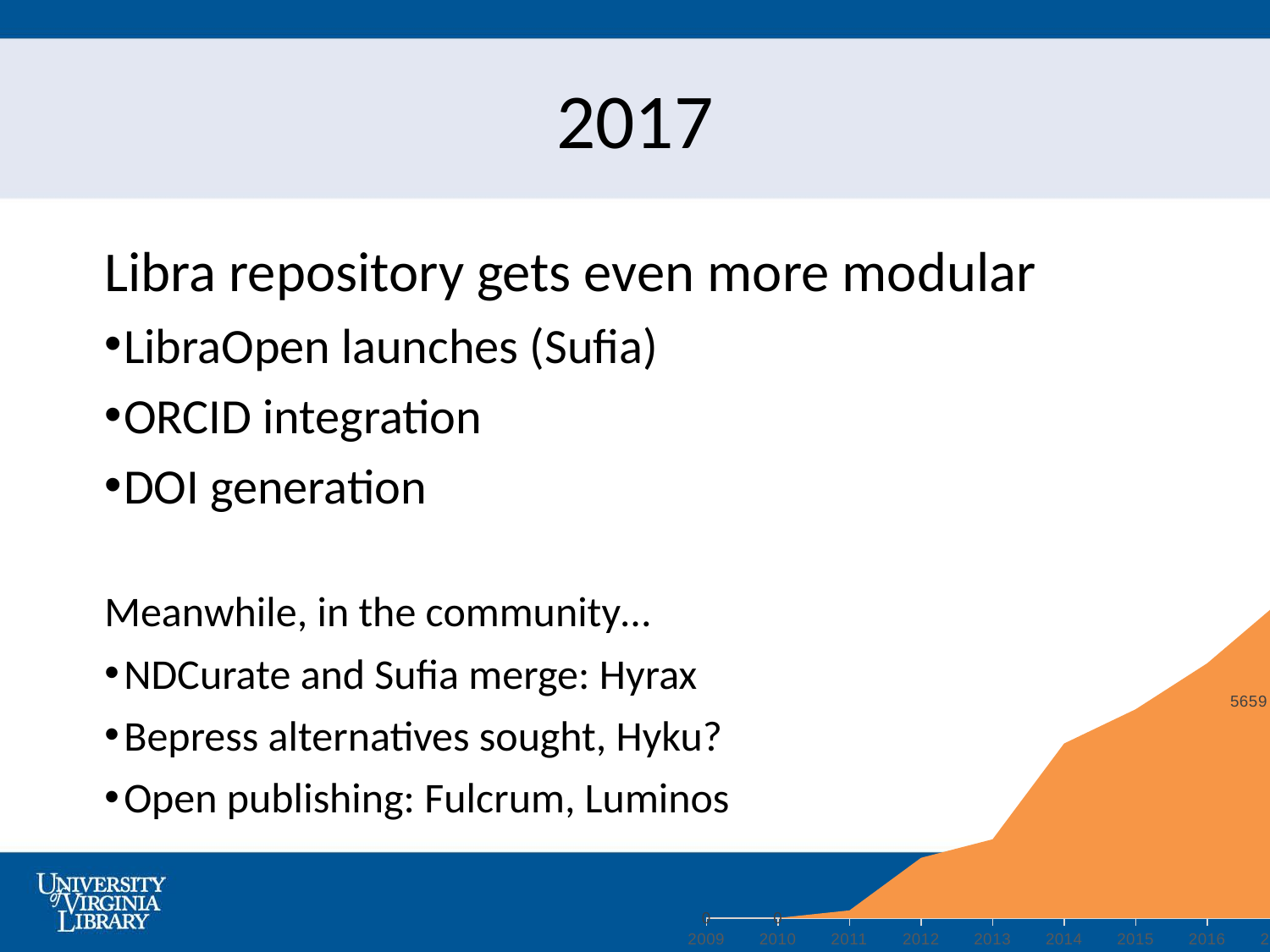
In the chart at the bottom right, which is larger, the value for 2014 or the value for 2011? 2014 What is the first year labelled on the x axis of the chart at the bottom right? 2009 Do the values in the chart at the bottom right rise or fall from 2009 to 2016? rise What kind of chart is shown at the bottom right of the slide? area chart What colour is the filled area in the chart at the bottom right? orange In the chart at the bottom right, which is larger, the value for 2012 or the value for 2015? 2015 In the chart at the bottom right, is the value for 2016 larger or smaller than the value for 2009? larger